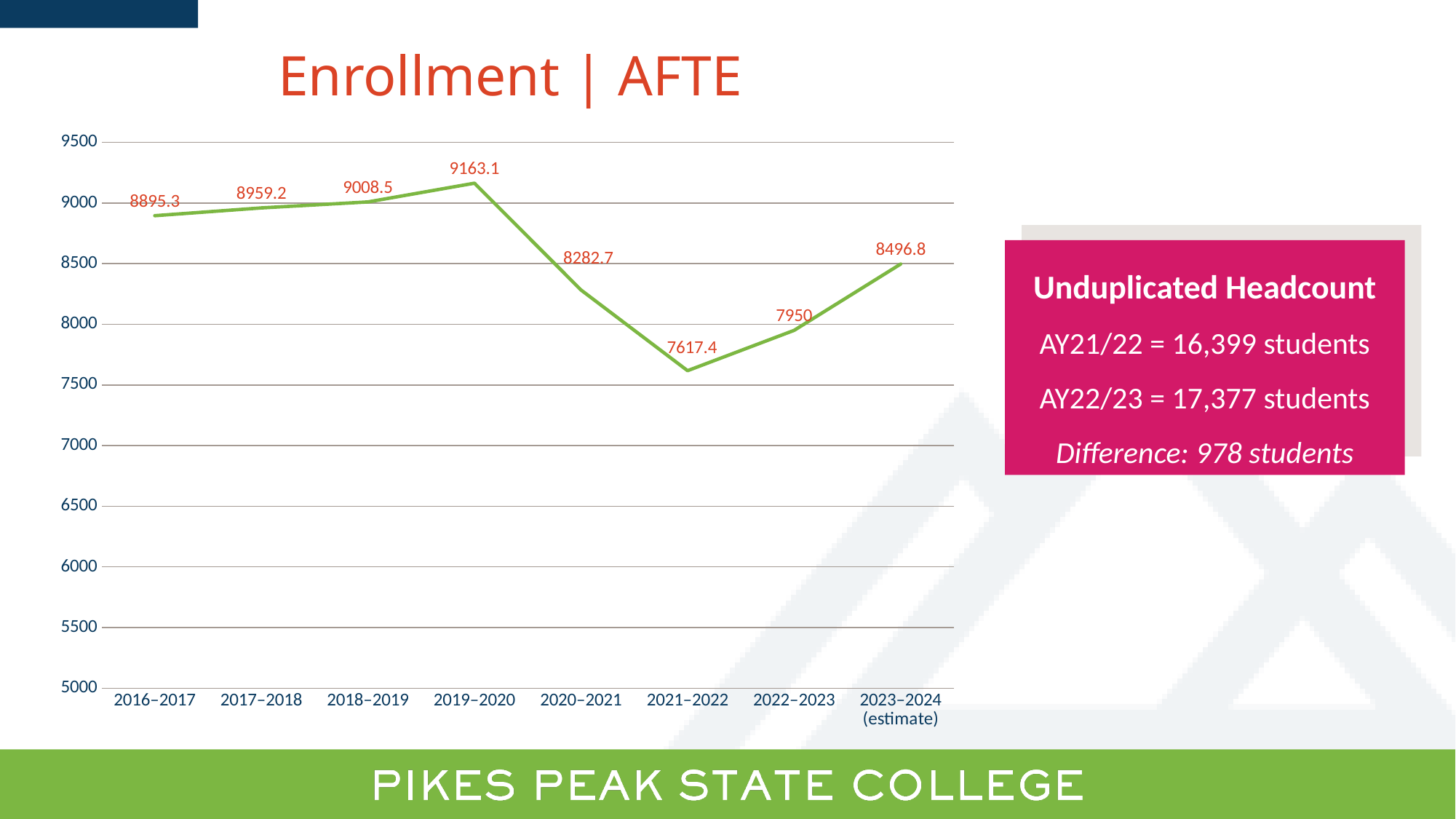
What is the estimated AFTE value for 2023–2024? 8496.8 How many academic years are plotted on the chart? 8 What kind of chart is shown on the slide? Line chart What is the difference between the 2023–2024 estimate and the 2022–2023 AFTE value? 546.8 What is the AFTE value for 2019–2020? 9163.1 What is the difference between the AFTE values for 2019–2020 and 2021–2022? 1545.7 How does the AFTE value change from 2019–2020 to 2021–2022? It falls Which is larger, the AFTE value for 2018–2019 or for 2020–2021? 2018–2019 Which academic year has the lowest AFTE value? 2021–2022 What is the AFTE value for 2022–2023? 7950 Which academic year has the highest AFTE value? 2019–2020 What is the AFTE value for 2021–2022? 7617.4